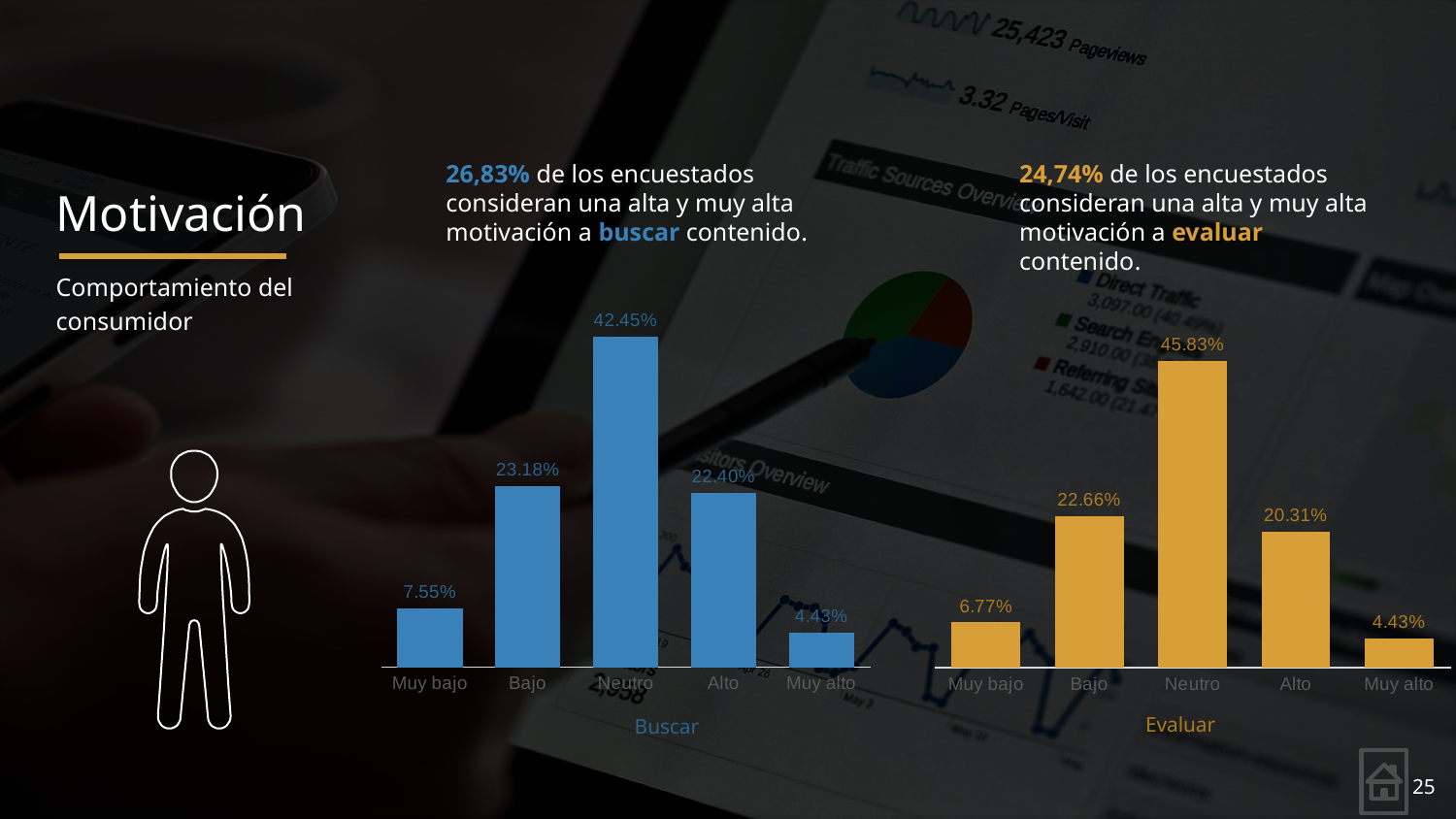
In the Buscar chart, what is the value for Muy bajo? 7.55% In the Buscar chart, what is the value for Neutro? 42.45% What colour are the bars in the Buscar chart? Blue In the Buscar chart, what is the difference between the values for Bajo and Alto? 0.78% In the Buscar chart, which category has the lowest value? Muy alto In the Evaluar chart, is the value for Alto larger than the value for Muy bajo? Yes How many categories are shown in the Buscar chart? 5 Which is larger: the Neutro value in the Buscar chart or the Neutro value in the Evaluar chart? Evaluar In the Evaluar chart, which category has the highest value? Neutro In the Evaluar chart, what is the difference between the values for Neutro and Alto? 25.52% What type of chart is the Evaluar chart? Bar chart In the Evaluar chart, what is the value for Bajo? 22.66%